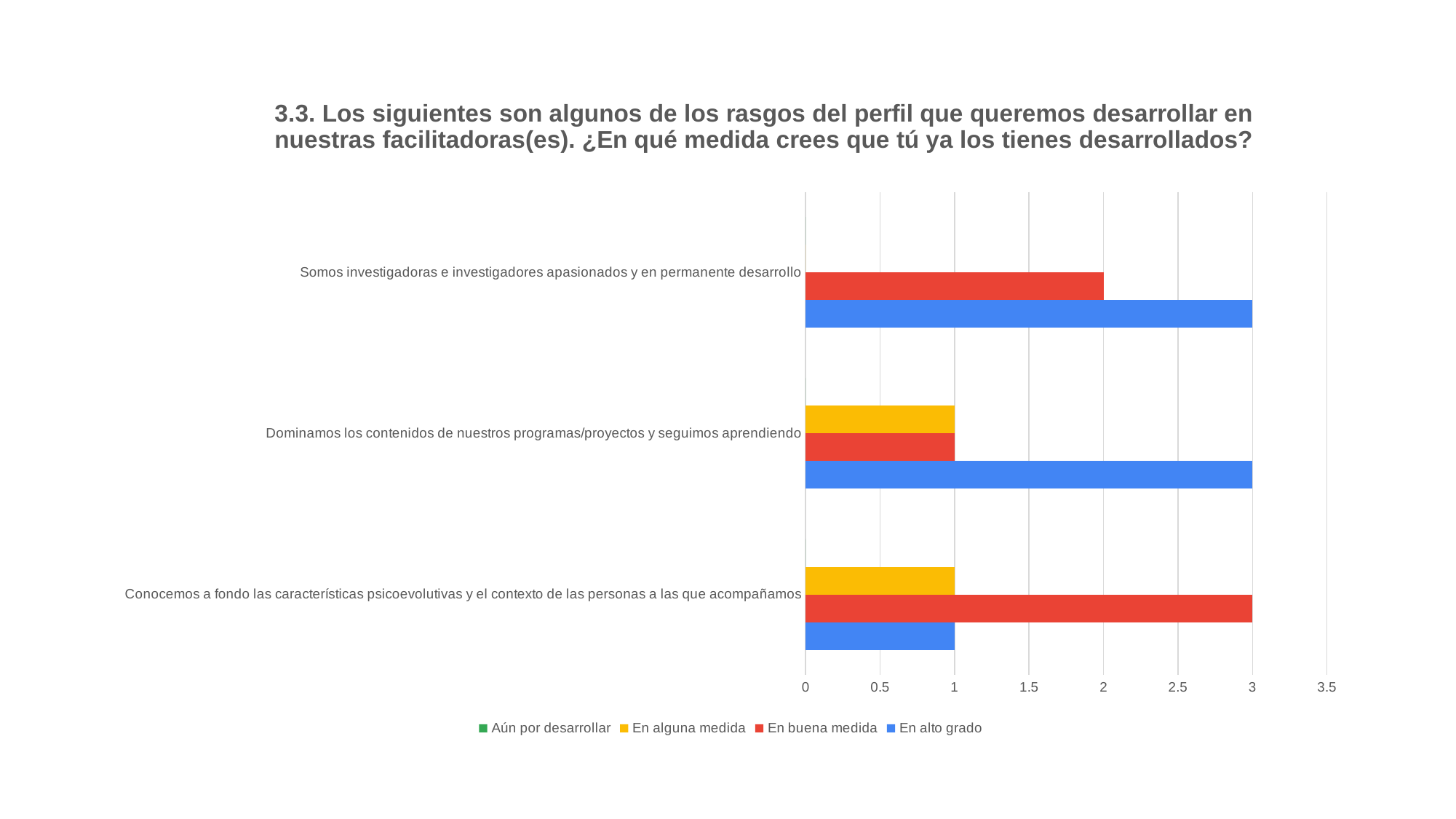
How many series does the legend list? 4 What is the value of 'En alto grado' for 'Somos investigadoras e investigadores apasionados y en permanente desarrollo'? 3 Which category has the highest value for 'En buena medida'? Conocemos a fondo las características psicoevolutivas y el contexto de las personas a las que acompañamos What kind of chart is shown on the slide? Bar chart Which legend entry is shown in green? Aún por desarrollar What is the value of 'En buena medida' for 'Conocemos a fondo las características psicoevolutivas y el contexto de las personas a las que acompañamos'? 3 For 'Conocemos a fondo las características psicoevolutivas y el contexto de las personas a las que acompañamos', which is larger: 'En buena medida' or 'En alto grado'? En buena medida What is the difference between 'En alto grado' and 'En buena medida' for 'Dominamos los contenidos de nuestros programas/proyectos y seguimos aprendiendo'? 2 What is the value of 'En buena medida' for 'Somos investigadoras e investigadores apasionados y en permanente desarrollo'? 2 How many categories are shown on the chart? 3 What is the value of 'En alguna medida' for 'Dominamos los contenidos de nuestros programas/proyectos y seguimos aprendiendo'? 1 Which category has the lowest value for 'En alto grado'? Conocemos a fondo las características psicoevolutivas y el contexto de las personas a las que acompañamos